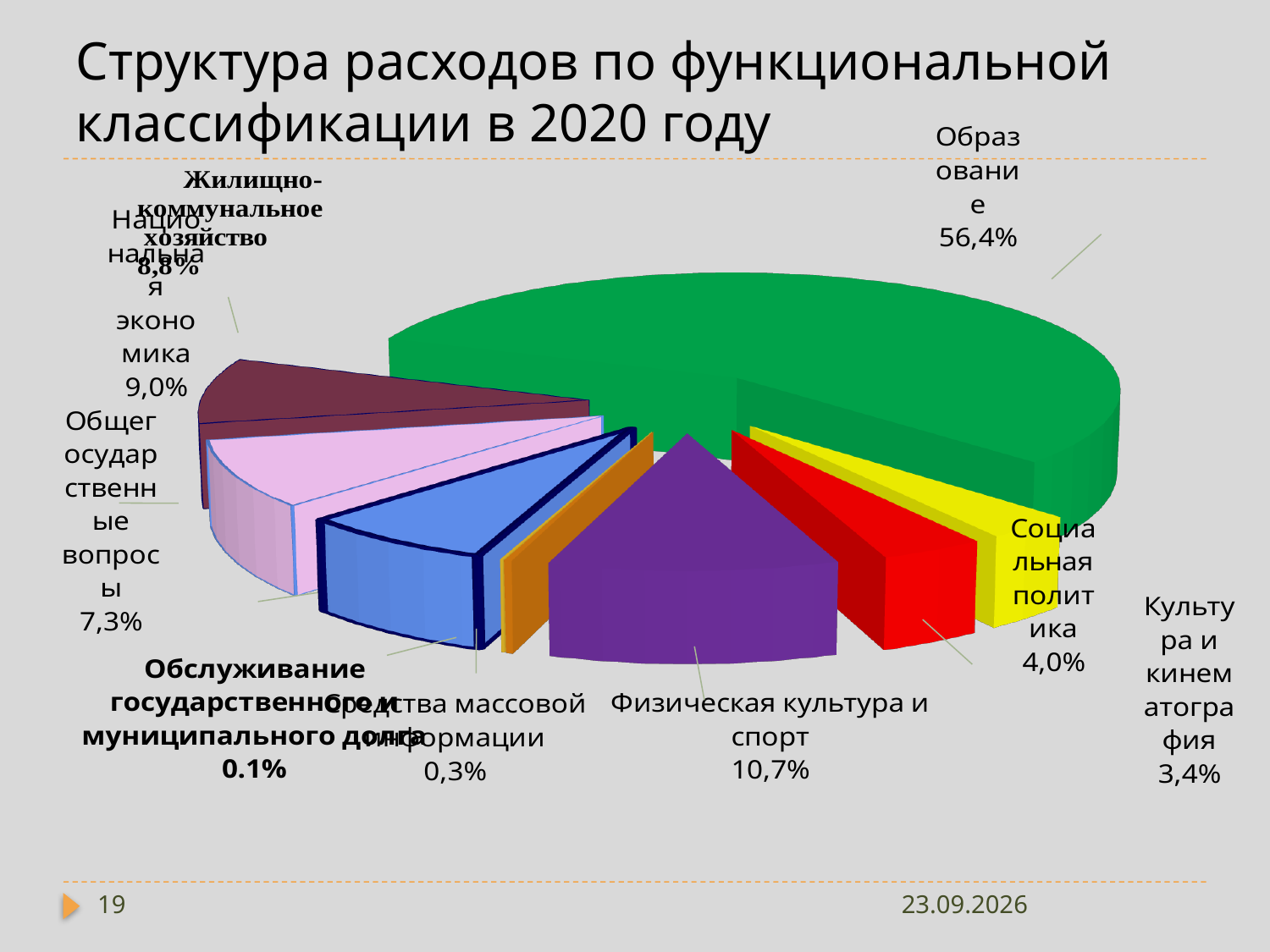
What is the value for Социальная политика? 4,0% How many categories are shown in the pie chart? 9 Which category has the largest share of expenditures? Образование What kind of chart is shown on the slide? pie chart What is the value for Физическая культура и спорт? 10,7% Which is larger: the share for Национальная экономика or for Жилищно-коммунальное хозяйство? Национальная экономика What is the difference between the shares of Физическая культура и спорт and Социальная политика? 6,7% Which category has the smallest share of expenditures? Обслуживание государственного и муниципального долга What is the value for Общегосударственные вопросы? 7,3% What is the value for Средства массовой информации? 0,3% What is the value for Культура и кинематография? 3,4% What share of expenditures goes to Образование? 56,4%